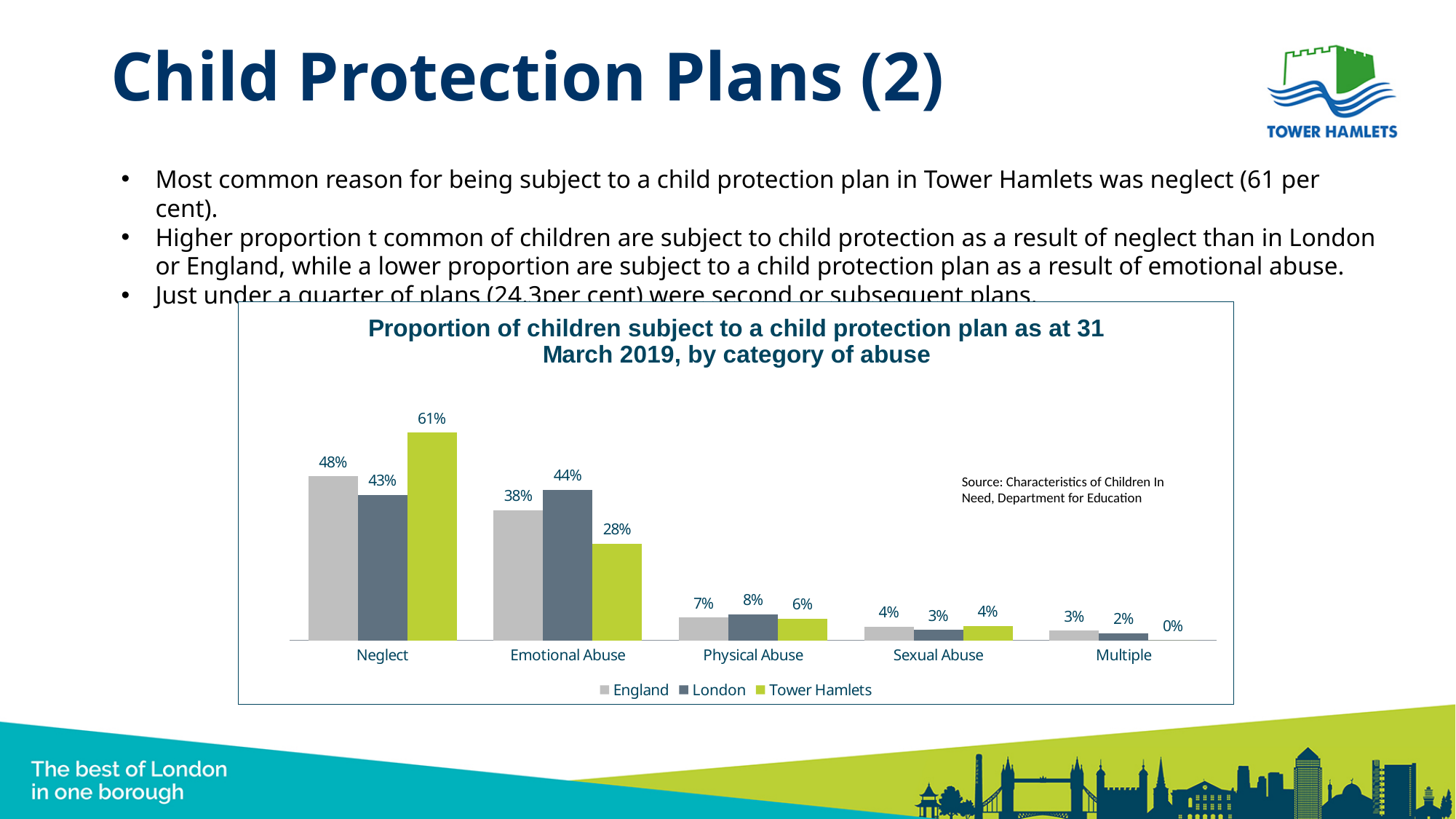
Which series is shown in green in the legend? Tower Hamlets Which category has the lowest London value? Multiple How many categories of abuse are shown on the x axis? 5 What is the London value for Emotional Abuse? 44% Which is larger for Emotional Abuse, the London value or the Tower Hamlets value? London What is the Tower Hamlets value for Neglect? 61% Which category has the highest Tower Hamlets value? Neglect What is the difference between the Tower Hamlets and England values for Neglect? 13% What is the Tower Hamlets value for Multiple? 0% What kind of chart is shown on the slide? Bar chart How many series does the legend list? 3 What is the England value for Physical Abuse? 7%